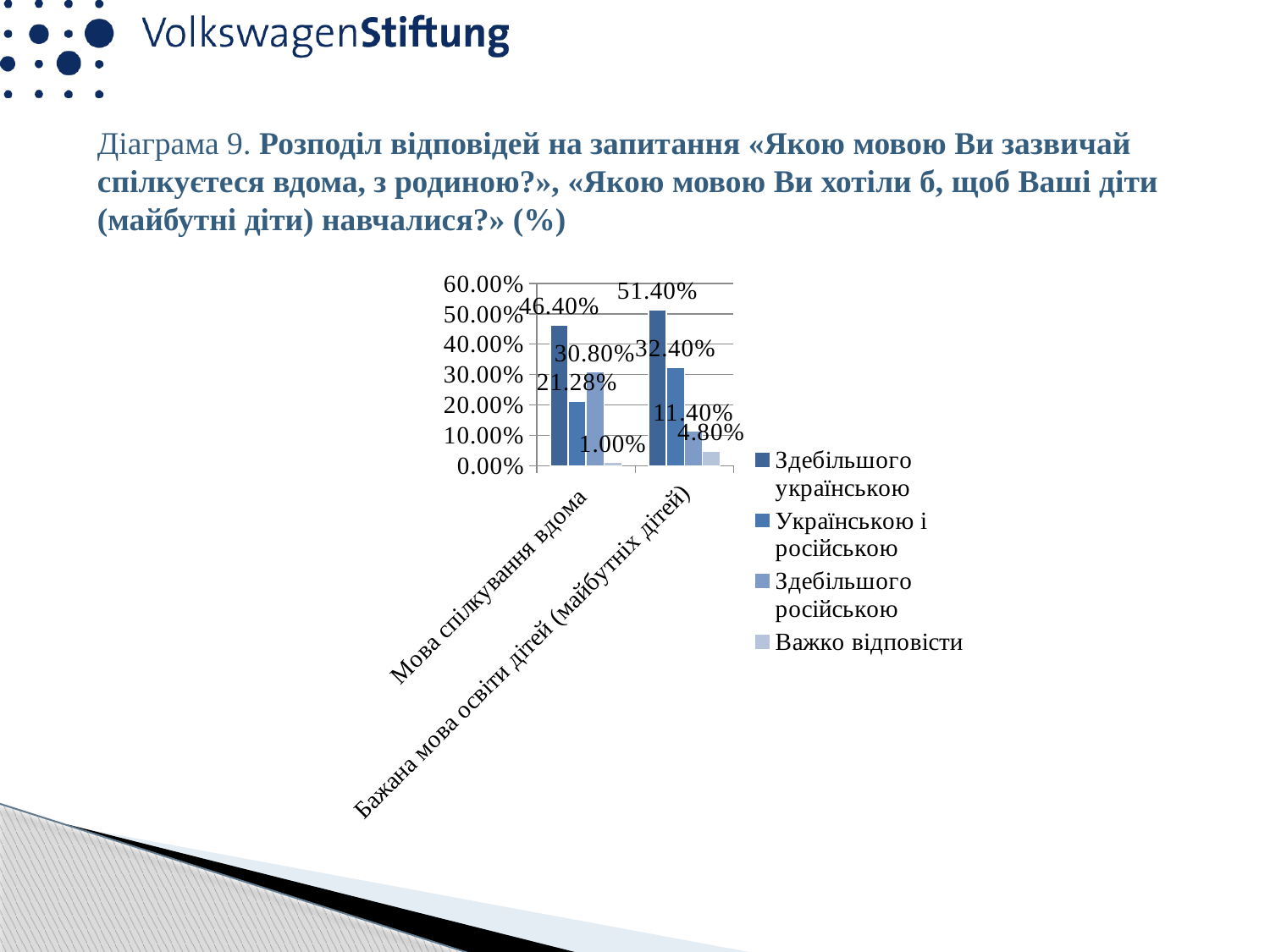
Is the value for «Здебільшого українською» in «Мова спілкування вдома» greater or less than 40.00%? greater What is the value for «Здебільшого російською» in the category «Мова спілкування вдома»? 30.80% What is the difference between «Здебільшого російською» for «Мова спілкування вдома» (30.80%) and for «Бажана мова освіти дітей (майбутніх дітей)» (11.40%)? 19.40% How many categories are shown on the x axis? 2 What is the value for «Важко відповісти» in the category «Бажана мова освіти дітей (майбутніх дітей)»? 4.80% What is the value for «Здебільшого українською» in the category «Мова спілкування вдома»? 46.40% What is the value for «Здебільшого українською» in the category «Бажана мова освіти дітей (майбутніх дітей)»? 51.40% Which series has the lowest value in the category «Мова спілкування вдома»? Важко відповісти Which is larger: «Українською і російською» for «Мова спілкування вдома» or for «Бажана мова освіти дітей (майбутніх дітей)»? Бажана мова освіти дітей (майбутніх дітей) How many series does the legend list? 4 What kind of chart is shown on the slide? bar chart Which series has the highest value in the category «Бажана мова освіти дітей (майбутніх дітей)»? Здебільшого українською